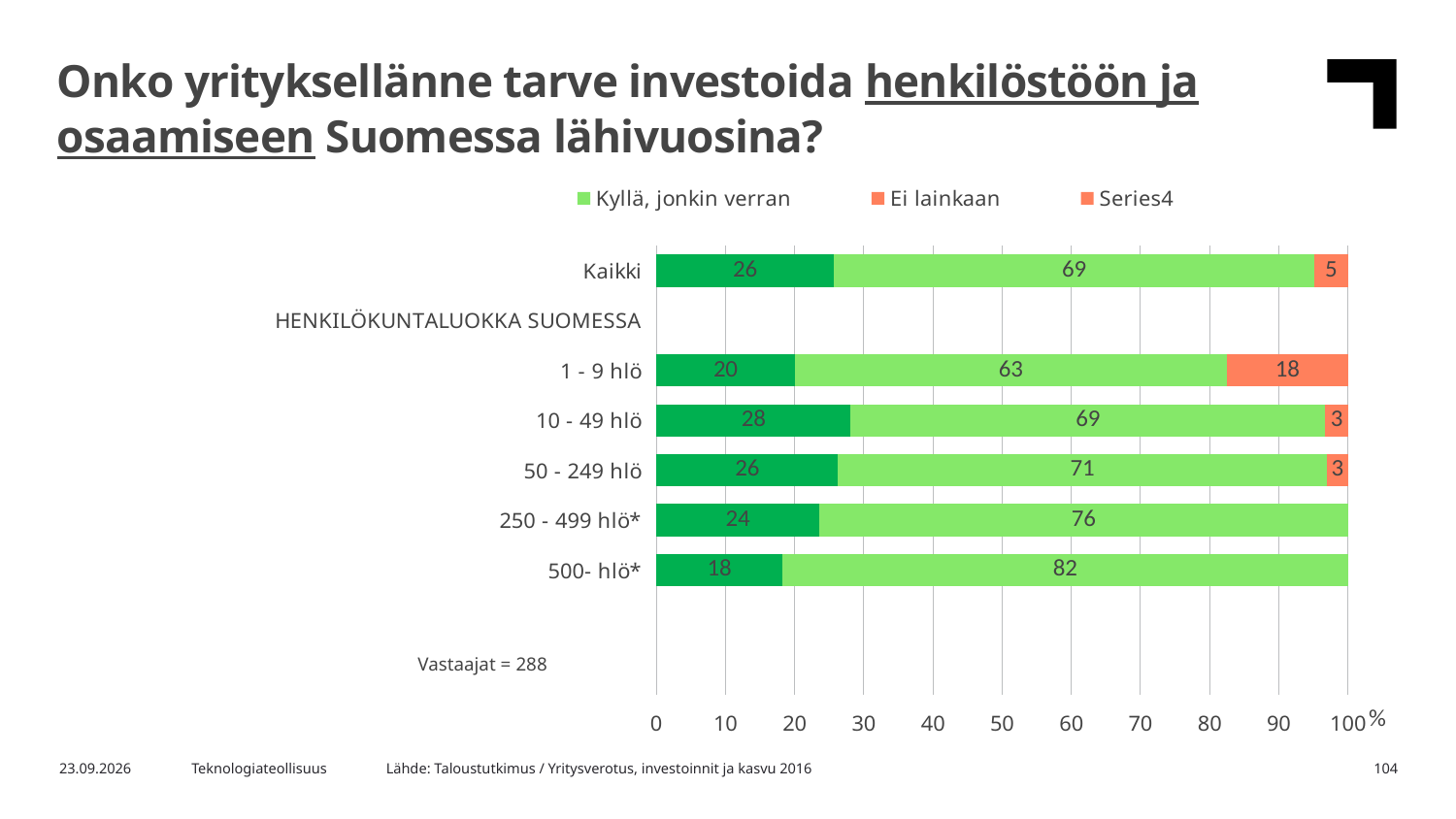
Which category has the highest 'Kyllä, jonkin verran' value? 500- hlö* What is the value of the 'Kyllä, jonkin verran' segment for the 'Kaikki' bar? 69 Which category has the highest 'Ei lainkaan' value? 1 - 9 hlö What kind of chart is shown on the slide? Stacked bar chart What is the difference between the 'Kyllä, jonkin verran' values for '500- hlö*' and '1 - 9 hlö'? 19 How many respondents (Vastaajat) does the chart report? 288 Which category has the lowest 'Kyllä, jonkin verran' value? 1 - 9 hlö What is the value of the 'Ei lainkaan' segment for the '1 - 9 hlö' bar? 18 How many series does the legend list? 3 What is the value of the dark green first segment for the '500- hlö*' bar? 18 Which has the larger dark green first segment: '10 - 49 hlö' or '250 - 499 hlö*'? 10 - 49 hlö What is the total of the stacked bar for 'Kaikki'? 100